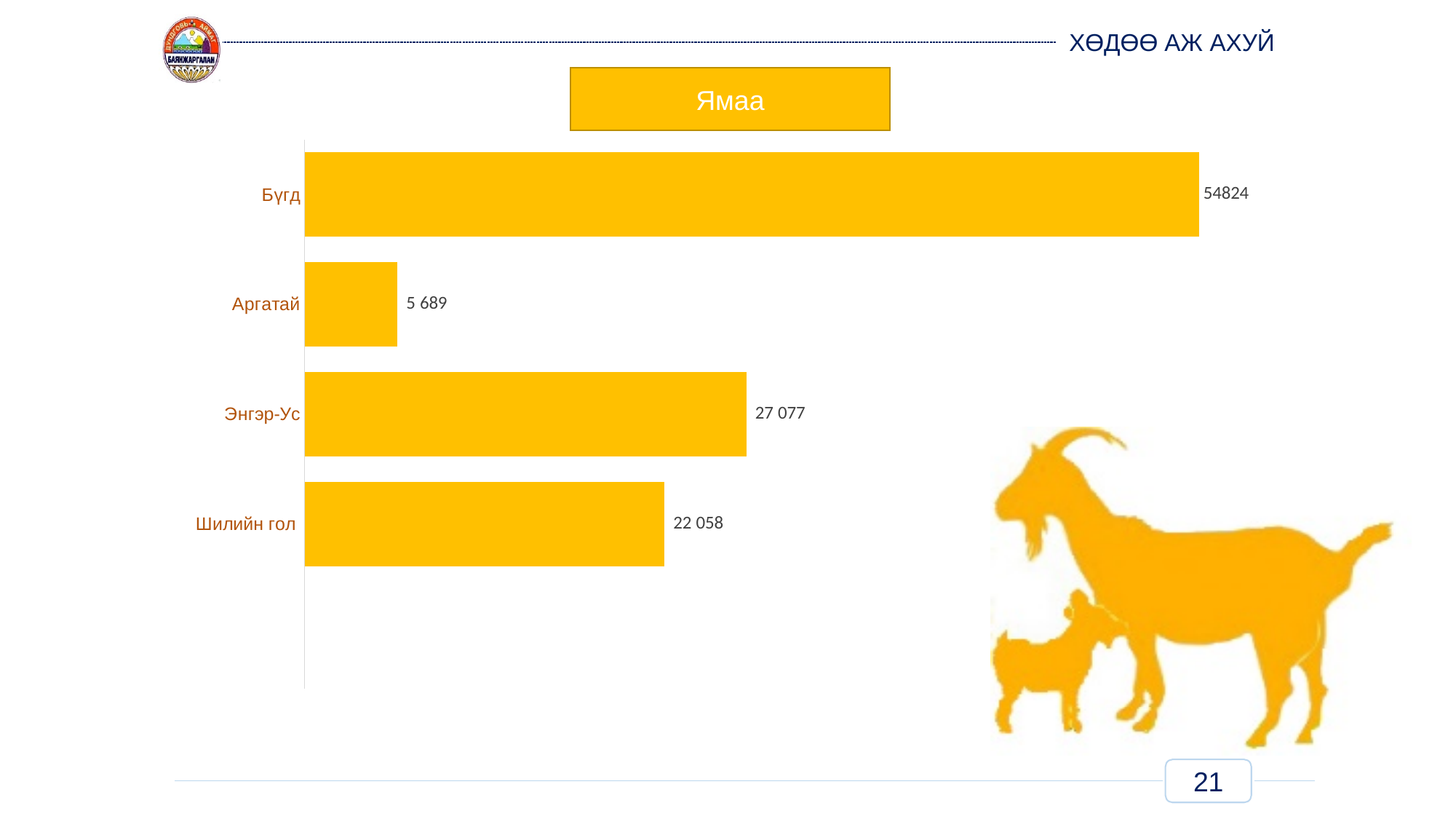
What is the value for Энгэр-Ус? 27 077 What kind of chart is shown on the slide? bar chart Which category has the lowest value? Аргатай How many categories are shown in the chart? 4 What is the value for Бүгд? 54824 What is the difference between the values for Энгэр-Ус and Шилийн гол? 5 019 Which category has the highest value? Бүгд What is the title of the chart? Ямаа Which is larger, the value for Энгэр-Ус or the value for Шилийн гол? Энгэр-Ус What is the value for Шилийн гол? 22 058 What is the value for Аргатай? 5 689 What is the difference between the values for Энгэр-Ус and Аргатай? 21 388